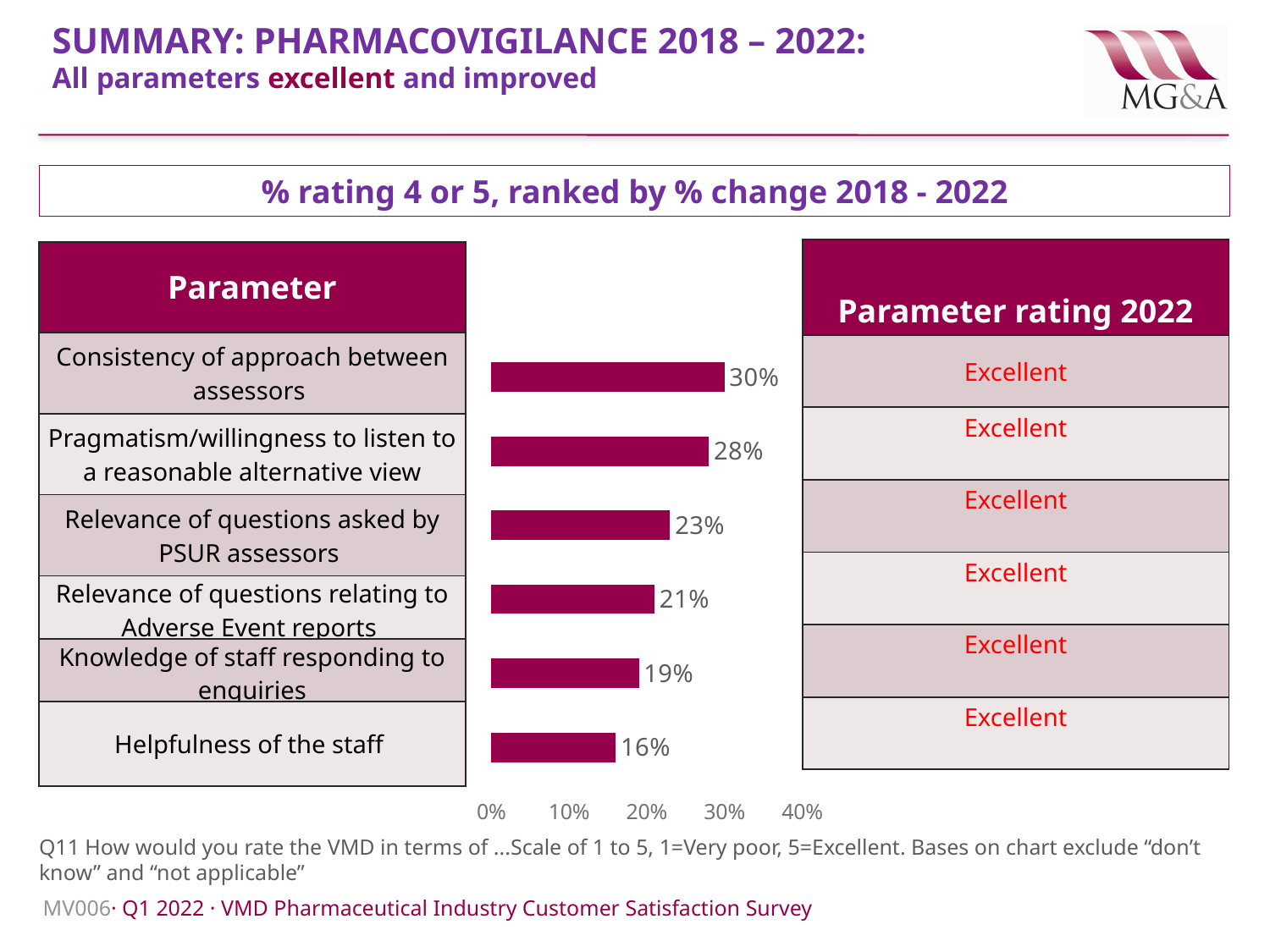
What is the % change for Helpfulness of the staff? 16% What is the % change for Consistency of approach between assessors? 30% What is the % change for Relevance of questions asked by PSUR assessors? 23% What is the difference between the % change for Consistency of approach between assessors and Helpfulness of the staff? 14% What is the % change for Knowledge of staff responding to enquiries? 19% Which parameter has the lowest % change? Helpfulness of the staff What is the title of the chart? % rating 4 or 5, ranked by % change 2018 - 2022 Which has a larger % change: Pragmatism/willingness to listen to a reasonable alternative view or Relevance of questions relating to Adverse Event reports? Pragmatism/willingness to listen to a reasonable alternative view What kind of chart is shown on the slide? Bar chart How many parameters are shown in the chart? 6 Is the value for Relevance of questions relating to Adverse Event reports greater or less than 30%? less Which parameter has the highest % change? Consistency of approach between assessors